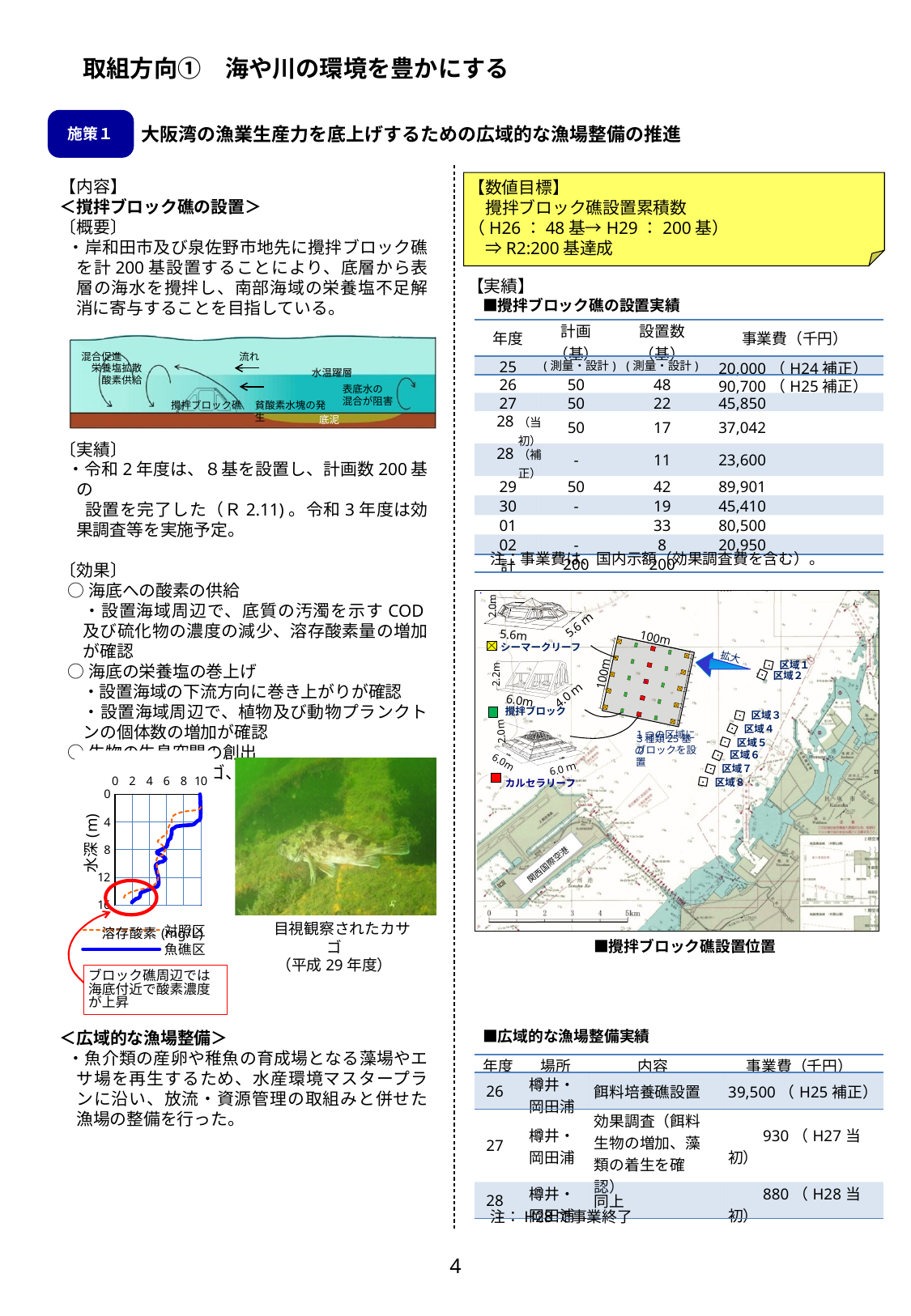
In the 溶存酸素 vs 水深 chart, does dissolved oxygen generally increase or decrease as depth increases from 0 m to 16 m? decrease What is the deepest value shown on the 水深 (m) axis of the line chart? 16 What are the two series named in the legend of the 溶存酸素 vs 水深 chart? 対照区 and 魚礁区 How many series does the legend of the 溶存酸素 vs 水深 chart list? 2 In the 溶存酸素 vs 水深 chart, is the dissolved oxygen for 魚礁区 at 0 m depth greater or less than 6? greater What is the label of the horizontal axis of the line chart on the lower left of the slide? 溶存酸素 (mg/L) In the 溶存酸素 vs 水深 chart, is the dissolved oxygen for 対照区 at 16 m depth greater or less than 4? less What is the largest value shown on the 溶存酸素 (mg/L) axis of the line chart? 10 In the 溶存酸素 vs 水深 chart, which series shows the higher dissolved oxygen near the seabed (around 16 m depth), 対照区 or 魚礁区? 魚礁区 What kind of chart is the 溶存酸素 (mg/L) vs 水深 (m) chart on the lower left of the slide? line chart